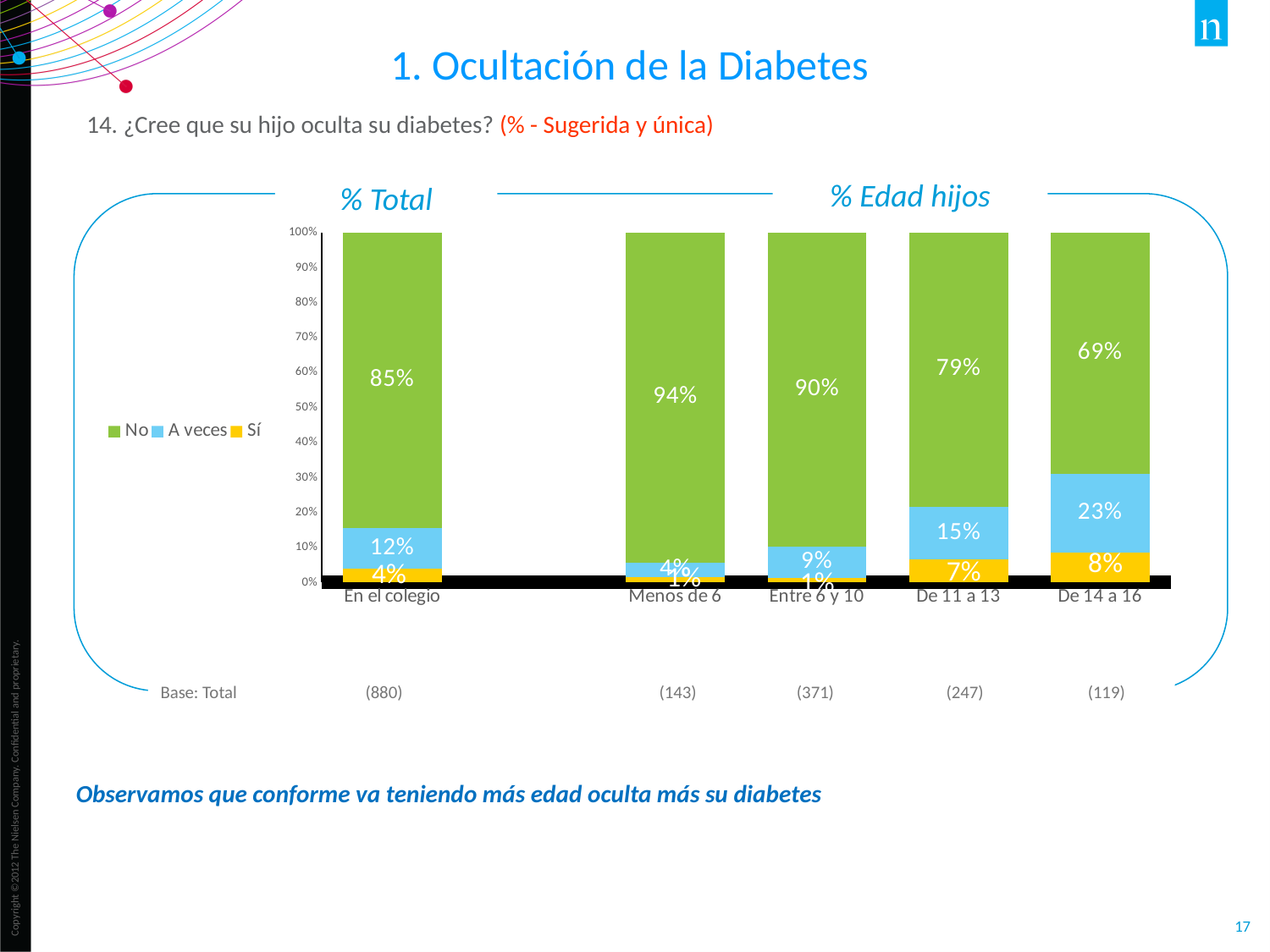
Which is larger: the 'A veces' value for 'De 11 a 13' or for 'En el colegio'? De 11 a 13 What is the value of the 'No' series for 'Menos de 6'? 94% What is the value of the 'No' series for 'En el colegio'? 85% How many categories are shown along the x axis? 5 What kind of chart is shown on the slide? Stacked bar chart Across the age groups from 'Menos de 6' to 'De 14 a 16', does the 'No' series rise or fall? Fall Which category has the lowest value for the 'No' series? De 14 a 16 Which category has the highest value for the 'No' series? Menos de 6 What is the difference between the 'No' values for 'Entre 6 y 10' and 'De 14 a 16'? 21% How many series does the legend list? 3 What is the value of the 'Sí' series for 'De 11 a 13'? 7% What is the value of the 'A veces' series for 'De 14 a 16'? 23%